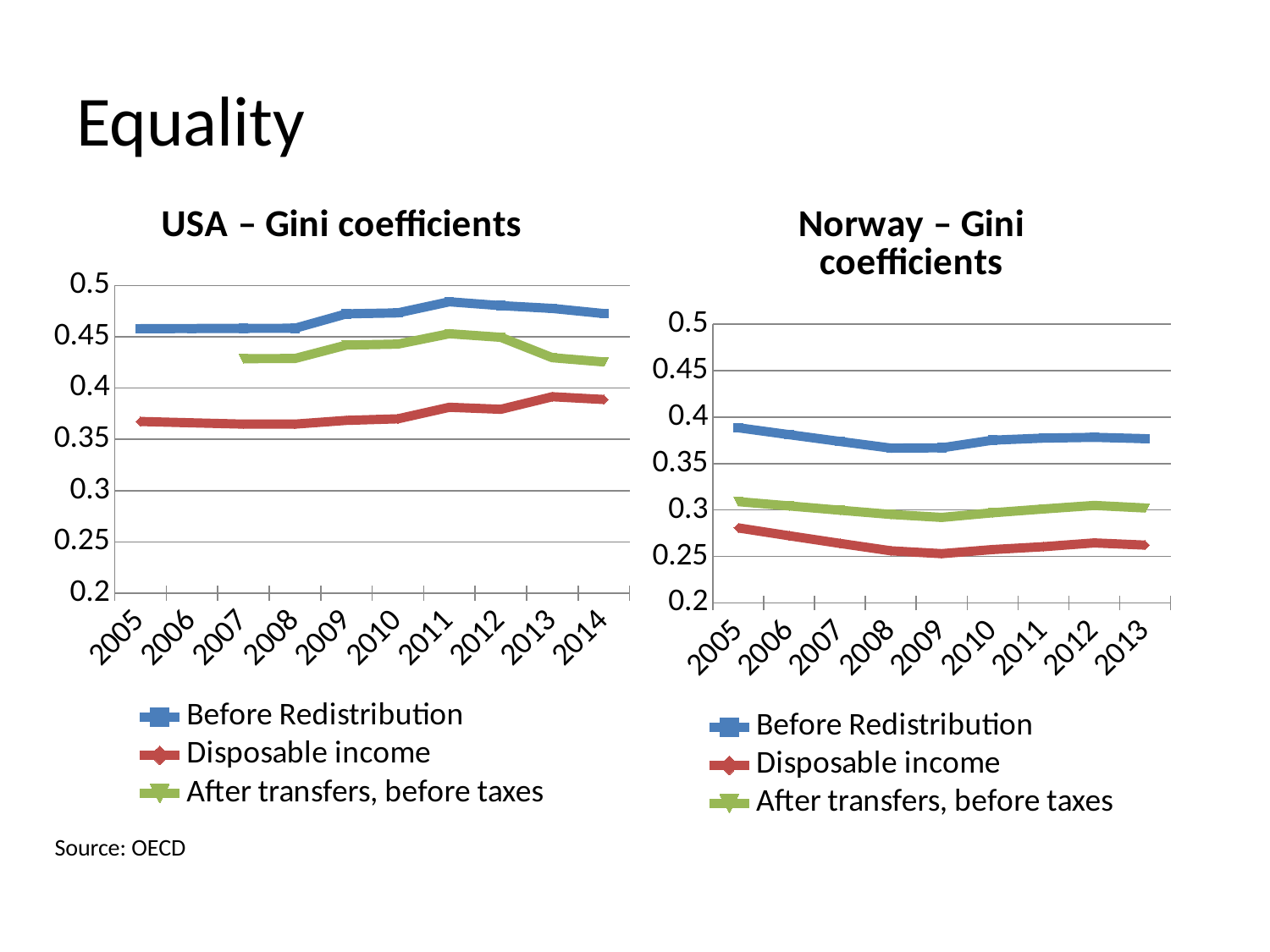
How many series does the legend of the Norway – Gini coefficients chart list? 3 In the Norway – Gini coefficients chart, is the Before Redistribution value for 2005 greater or less than 0.4? less In the USA – Gini coefficients chart, which series has the highest values across all years? Before Redistribution How many years are shown on the x axis of the USA – Gini coefficients chart? 10 In the Norway – Gini coefficients chart, is the Disposable income value for 2005 greater or less than 0.3? less In the USA – Gini coefficients chart, is the Before Redistribution value for 2011 greater or less than 0.45? greater In the Norway – Gini coefficients chart, does the Before Redistribution series rise or fall from 2005 to 2009? fall How many years are shown on the x axis of the Norway – Gini coefficients chart? 9 What kind of chart is the USA – Gini coefficients chart? line chart Which series is shown in green in the legend of the USA – Gini coefficients chart? After transfers, before taxes In the USA – Gini coefficients chart, in which year does the Before Redistribution series reach its highest value? 2011